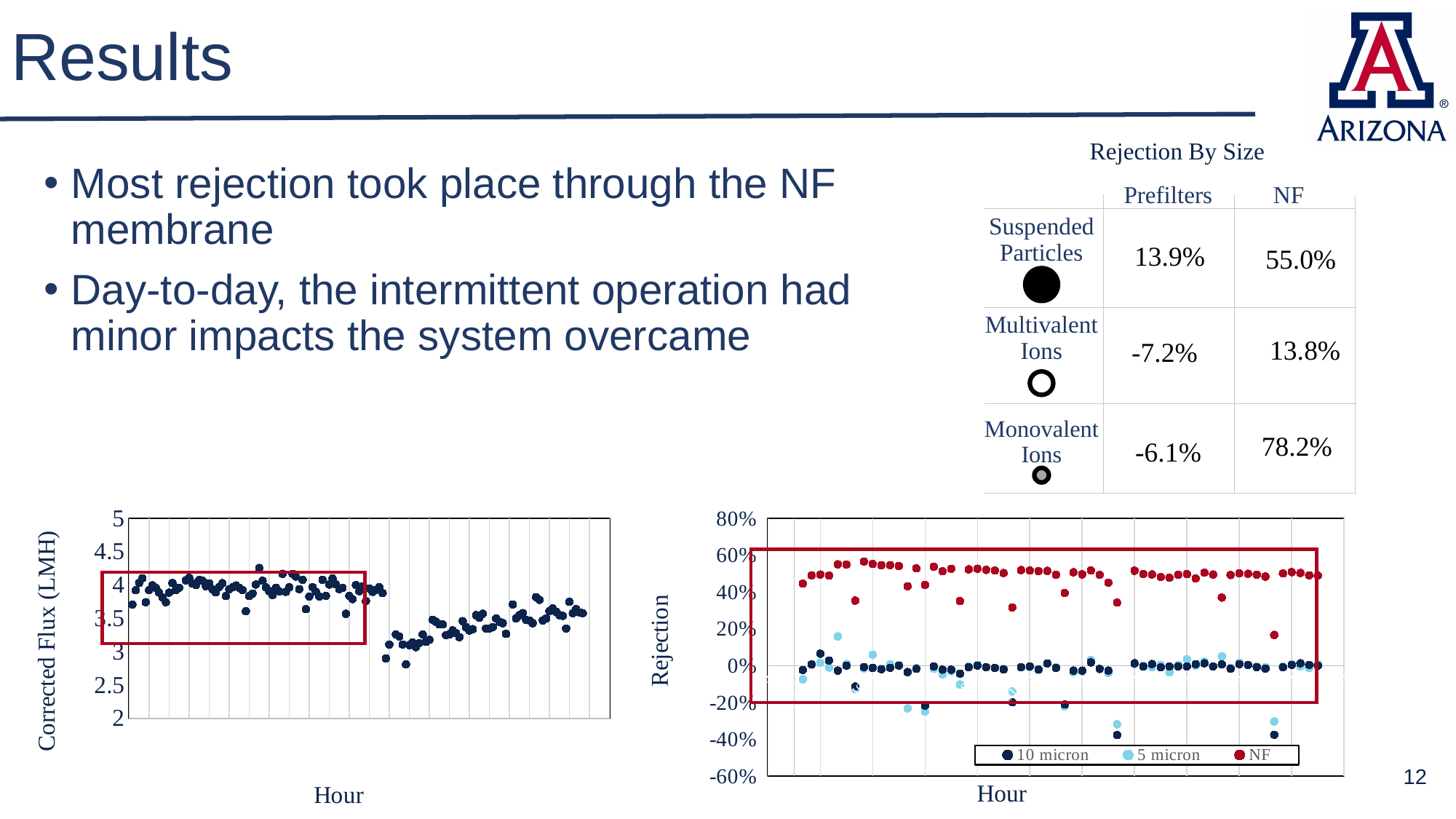
In the bottom-right chart, which series has lower values overall, NF or 10 micron? 10 micron In the bottom-right chart, what is the label of the y axis? Rejection In the bottom-right chart, which series has the highest rejection values? NF In the bottom-left chart, do the Corrected Flux values generally rise or fall as Hour increases? fall In the bottom-left chart, is the highest Corrected Flux value greater or less than 4.5? less In the bottom-right chart, is the lowest 10 micron value greater or less than -20%? less In the bottom-left chart, is the lowest Corrected Flux value greater or less than 3? less What kind of chart is the chart on the bottom right of the slide? Scatter chart In the bottom-right chart, how many series does the legend list? 3 In the bottom-right chart, what are the series named in the legend? 10 micron, 5 micron, NF What kind of chart is the chart on the bottom left of the slide? Scatter chart